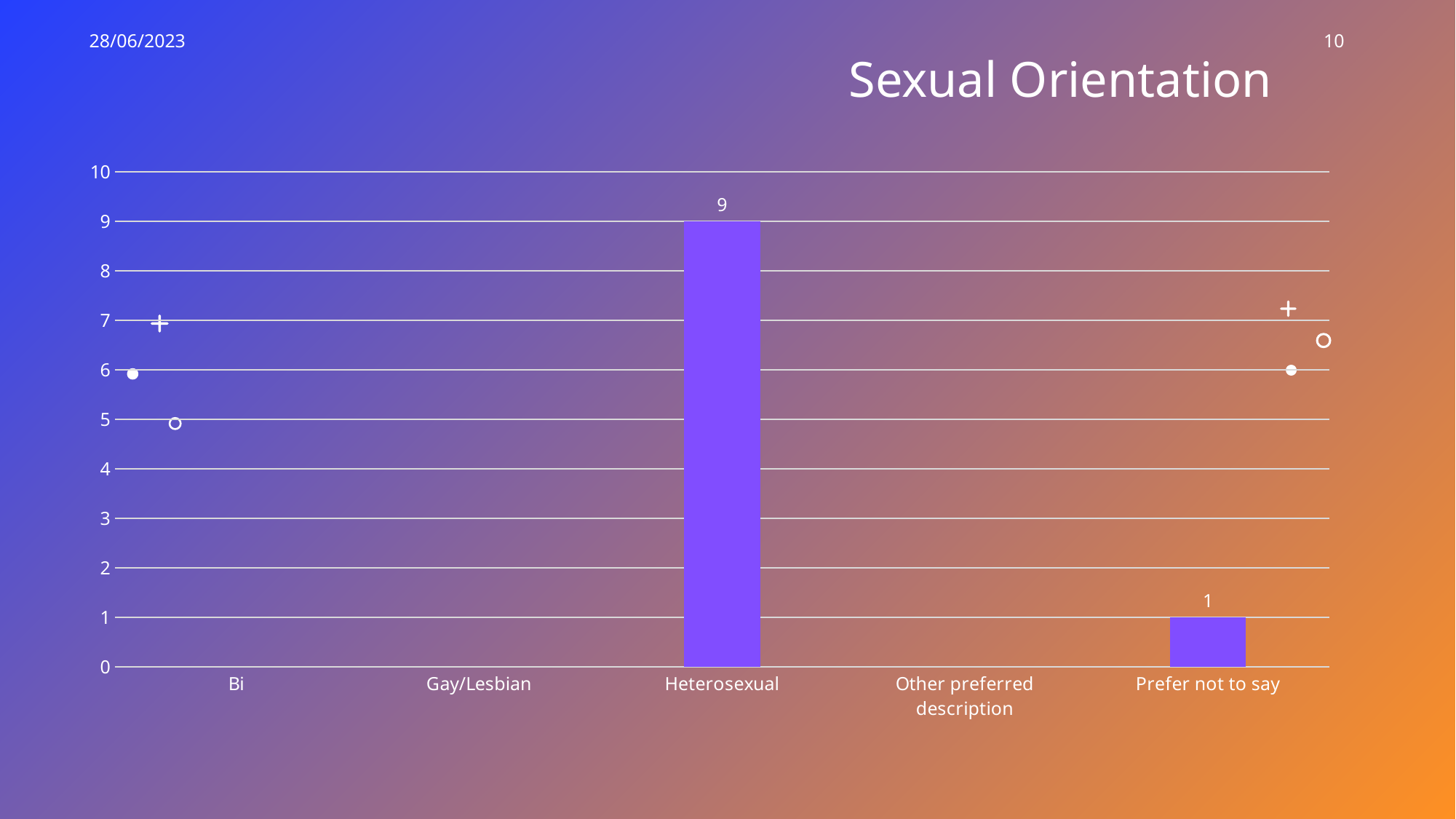
Is the value for Heterosexual greater or less than 5? greater What is the difference between the values for Heterosexual and Prefer not to say? 8 Which is larger, the value for Heterosexual or the value for Prefer not to say? Heterosexual What is the highest value shown on the y axis? 10 What kind of chart is shown on the slide? Bar chart What is the value for Prefer not to say? 1 Which category has the highest value? Heterosexual How many categories are shown on the x axis? 5 Is the value for Prefer not to say greater or less than 5? less What is the title of the chart? Sexual Orientation What is the value for Heterosexual? 9